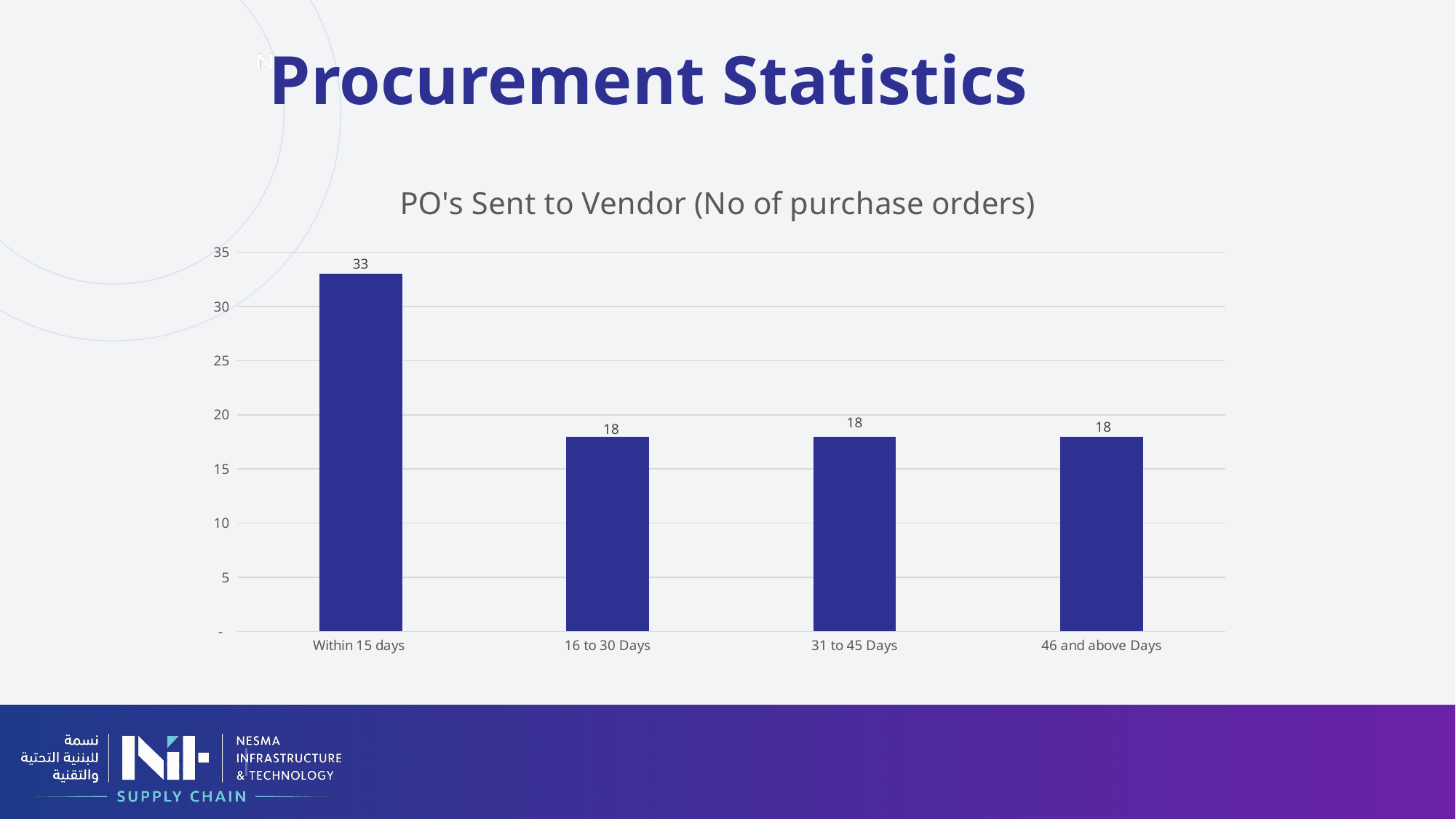
What is the value for '46 and above Days'? 18 What is the difference between the values for 'Within 15 days' and '31 to 45 Days'? 15 Which is larger, the value for 'Within 15 days' or the value for '16 to 30 Days'? Within 15 days What is the total of all four bars? 87 Which category has the highest number of purchase orders? Within 15 days What is the value for '16 to 30 Days'? 18 What is the value for 'Within 15 days'? 33 How many categories are shown on the x axis? 4 Is the value for 'Within 15 days' greater or less than 30? greater What kind of chart is shown on the slide? Bar chart Is the value for '31 to 45 Days' greater or less than 20? less What is the title of the chart? PO's Sent to Vendor (No of purchase orders)